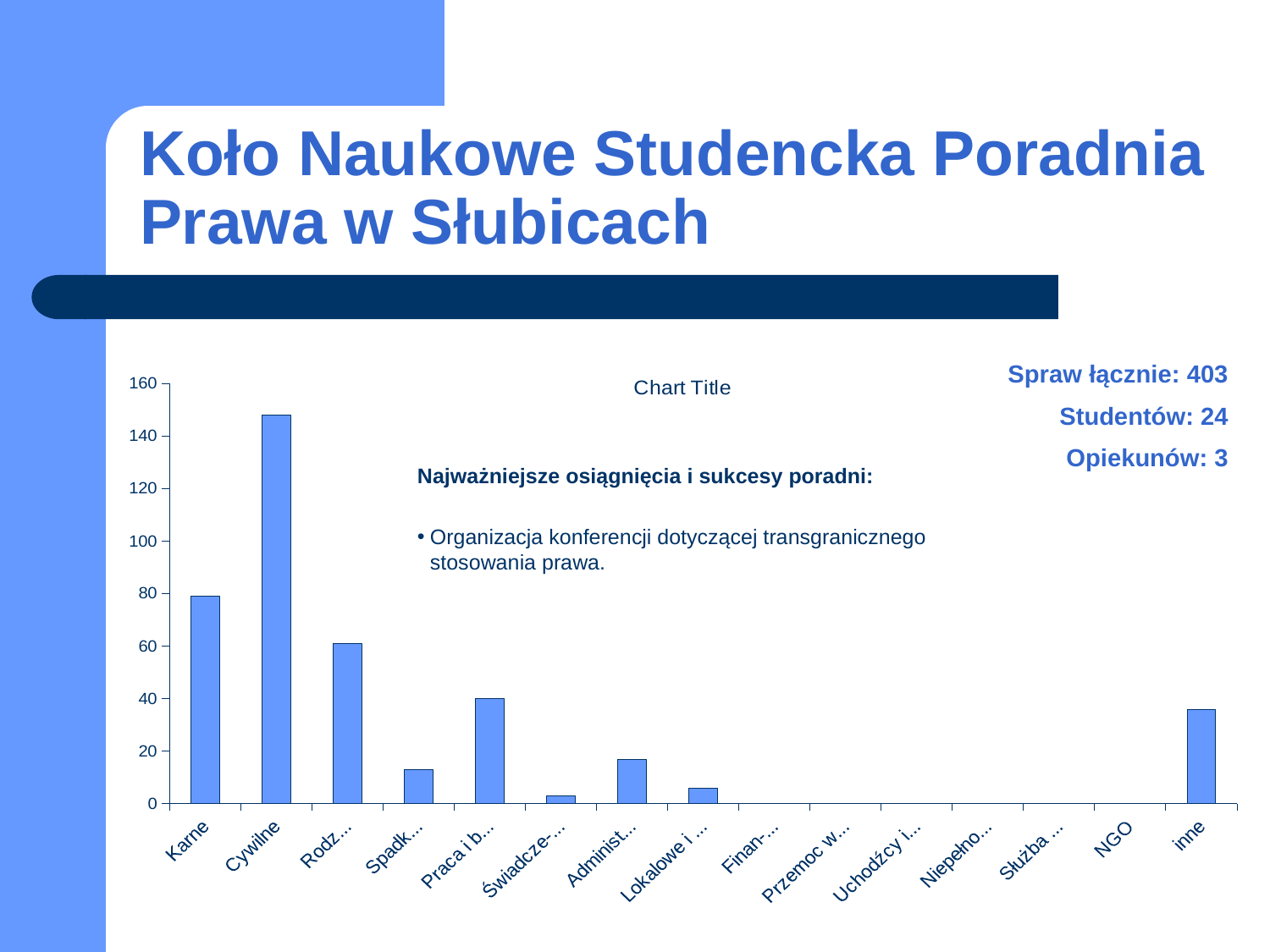
Which category has the highest value in the chart? Cywilne What is the title shown on the chart? Chart Title Is the value for Karne greater or less than 100? less Is the value for inne greater or less than 20? greater Which is larger, the value for Praca i b... or the value for Administ...? Praca i b... What kind of chart is shown on the slide? bar chart Is the value for Rodz... greater or less than 80? less Which is larger, the value for Karne or the value for Rodz...? Karne How many categories are shown on the x axis of the chart? 15